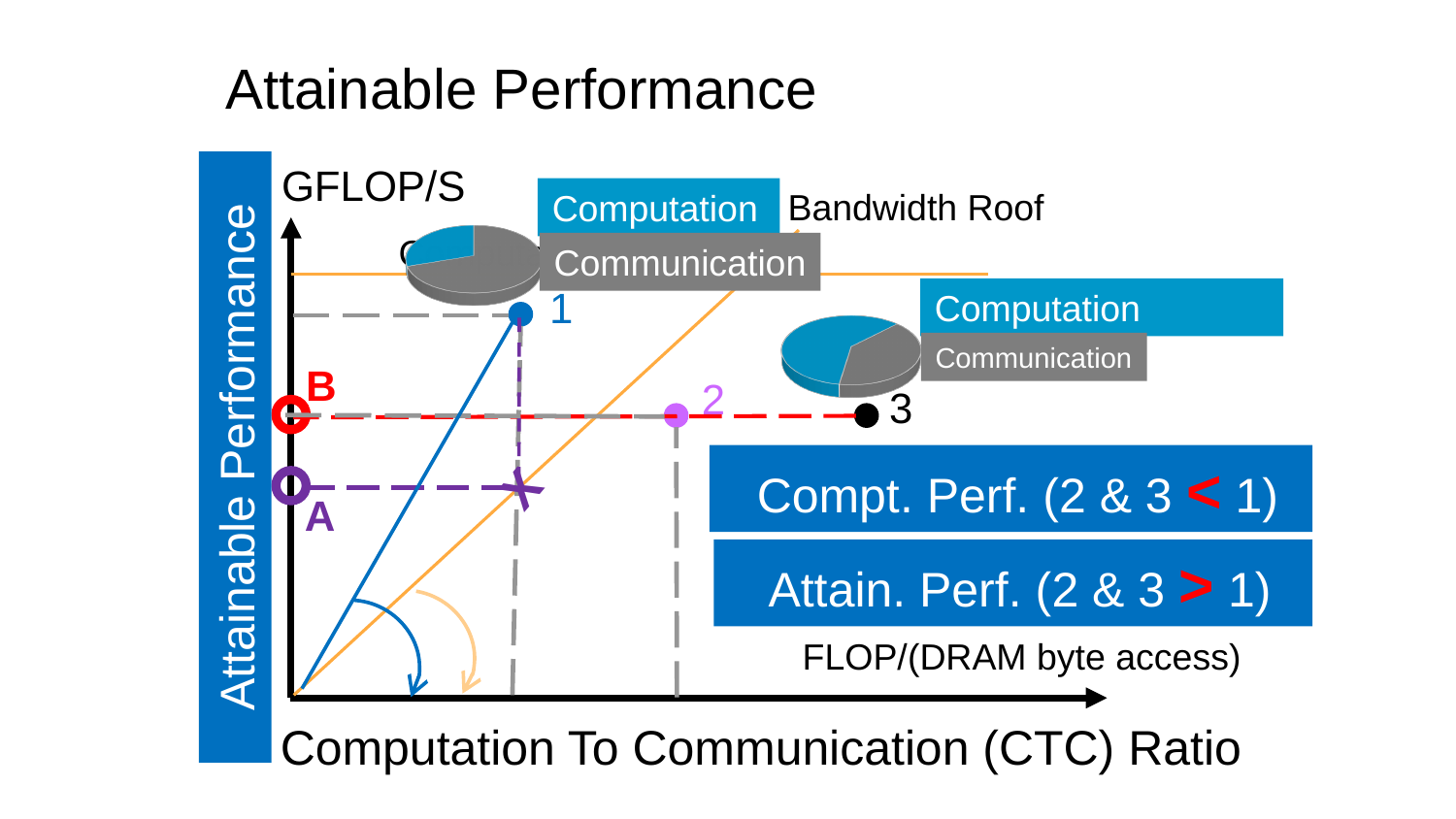
Do points 2 and 3 have the same or different attainable performance? Same How many numbered points (1, 2, 3) are plotted on the diagram? 3 What is the horizontal orange line at the top of the diagram called? Bandwidth Roof How many categories do the pie charts distinguish (Computation and Communication)? 2 Which has a larger CTC ratio, point 1 or point 2? Point 2 Which numbered point has the largest Computation To Communication (CTC) Ratio? Point 3 Which has a higher attainable performance, point 1 or point 2? Point 2 What kind of chart is shown beside point 1 comparing Computation and Communication? Pie chart What is the label of the x axis? Computation To Communication (CTC) Ratio